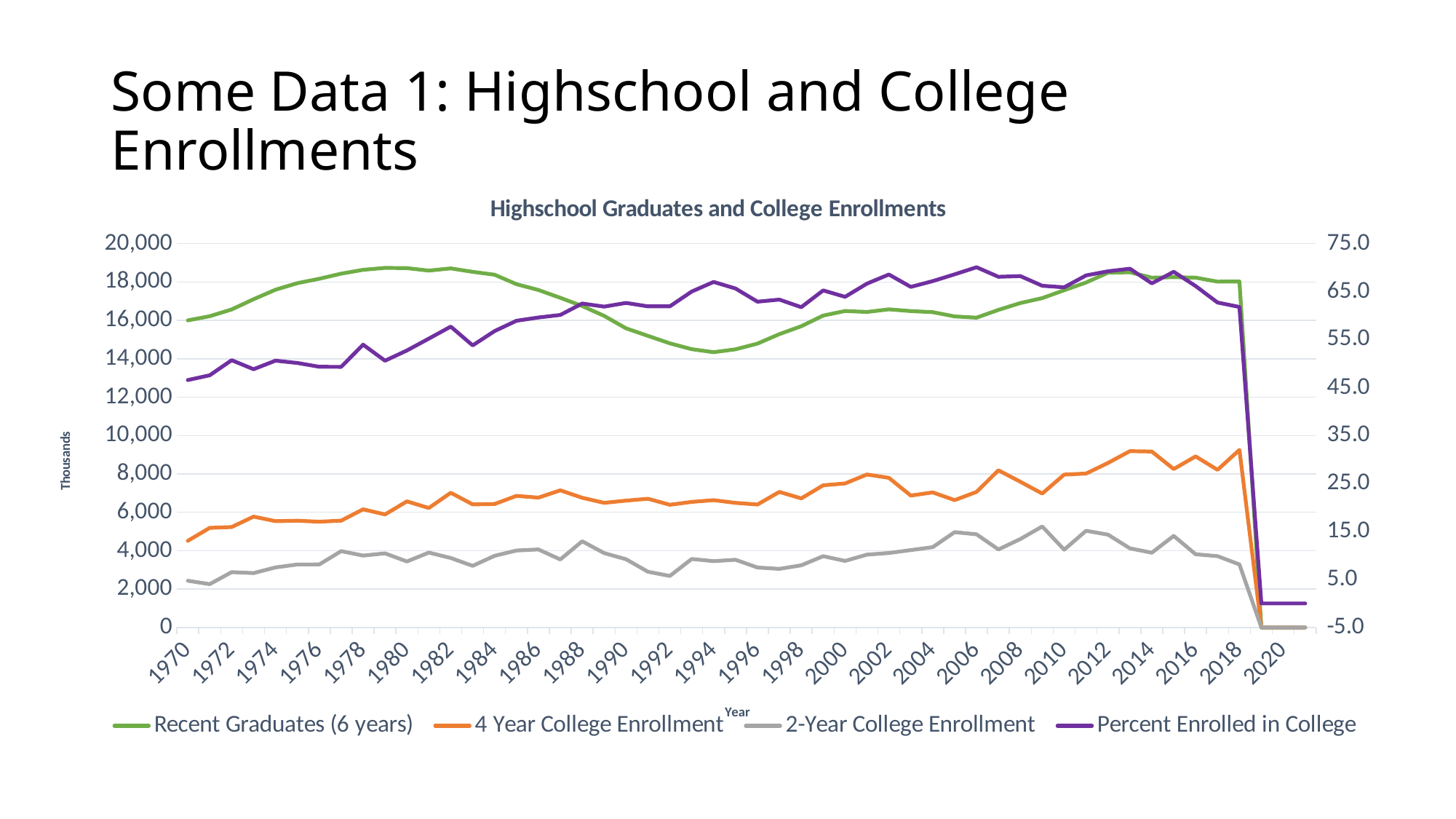
What is the label on the left vertical axis? Thousands Is the value for Recent Graduates (6 years) in 1994 greater or less than 16,000? less Is the value for 4 Year College Enrollment in 1970 greater or less than 4,000? greater Does the Recent Graduates (6 years) line rise or fall between 1980 and 1994? fall How many series does the legend list? 4 What is the title of the chart? Highschool Graduates and College Enrollments Does the 4 Year College Enrollment line generally rise or fall between 1970 and 2018? rise What kind of chart is shown on the slide? line chart Is the value for Percent Enrolled in College in 1970 greater or less than 55.0 on the right axis? less In 2000, which is higher: 4 Year College Enrollment or 2-Year College Enrollment? 4 Year College Enrollment